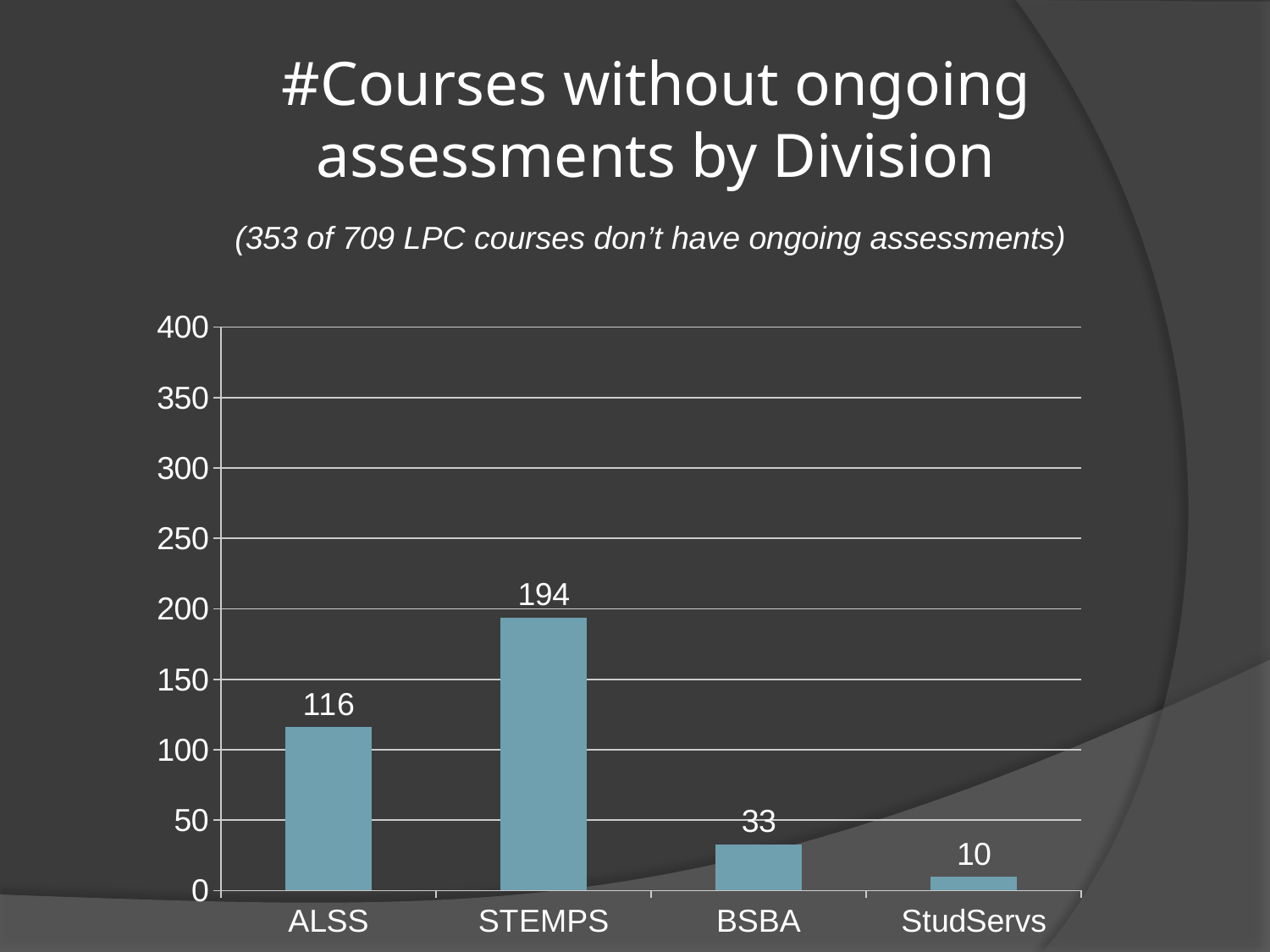
Which is larger, the value for ALSS or the value for BSBA? ALSS Which division has the lowest number of courses without ongoing assessments? StudServs What is the value for ALSS? 116 What kind of chart is shown on the slide? bar chart What is the value for STEMPS? 194 What is the value for BSBA? 33 How many divisions are shown on the chart? 4 Which division has the highest number of courses without ongoing assessments? STEMPS What is the difference between the values for BSBA and StudServs? 23 What is the value for StudServs? 10 Is the value for ALSS greater or less than 100? greater What is the difference between the values for STEMPS and ALSS? 78